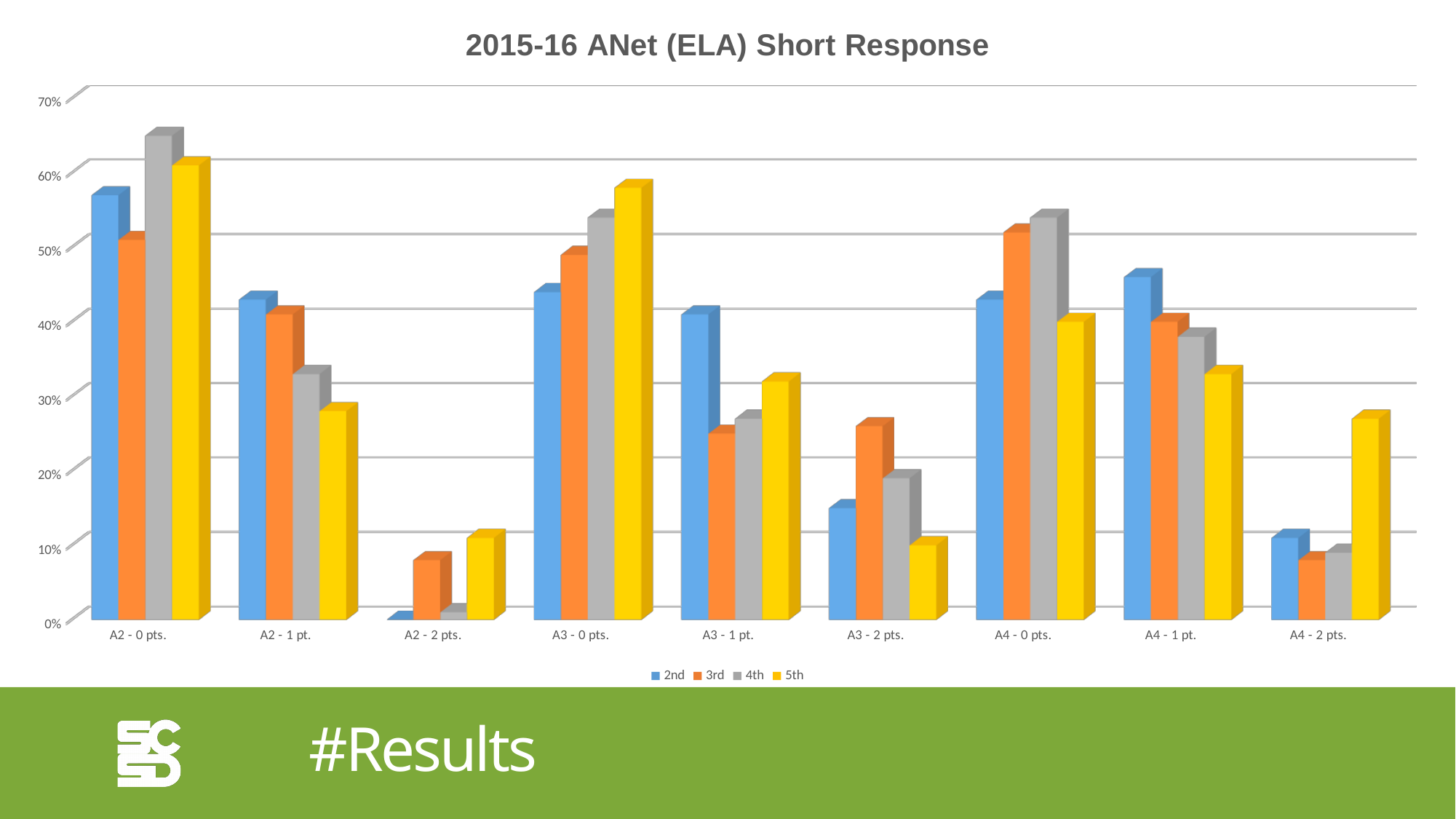
For A3 - 2 pts., which is larger: the 3rd grade value or the 5th grade value? 3rd Is the 5th grade value for A4 - 2 pts. greater or less than 20%? greater For A2 - 1 pt., which grade has the lowest value? 5th How many categories are shown along the x axis? 9 What kind of chart is shown on the slide? bar chart What is the title of the chart? 2015-16 ANet (ELA) Short Response Is the 2nd grade value for A2 - 0 pts. greater or less than 50%? greater For A4 - 2 pts., which grade has the highest value? 5th How many series does the legend list? 4 Which colour represents the 5th grade series in the legend? yellow For A2 - 0 pts., which grade has the highest value? 4th For A3 - 0 pts., do the values rise or fall going from 2nd grade to 5th grade? rise